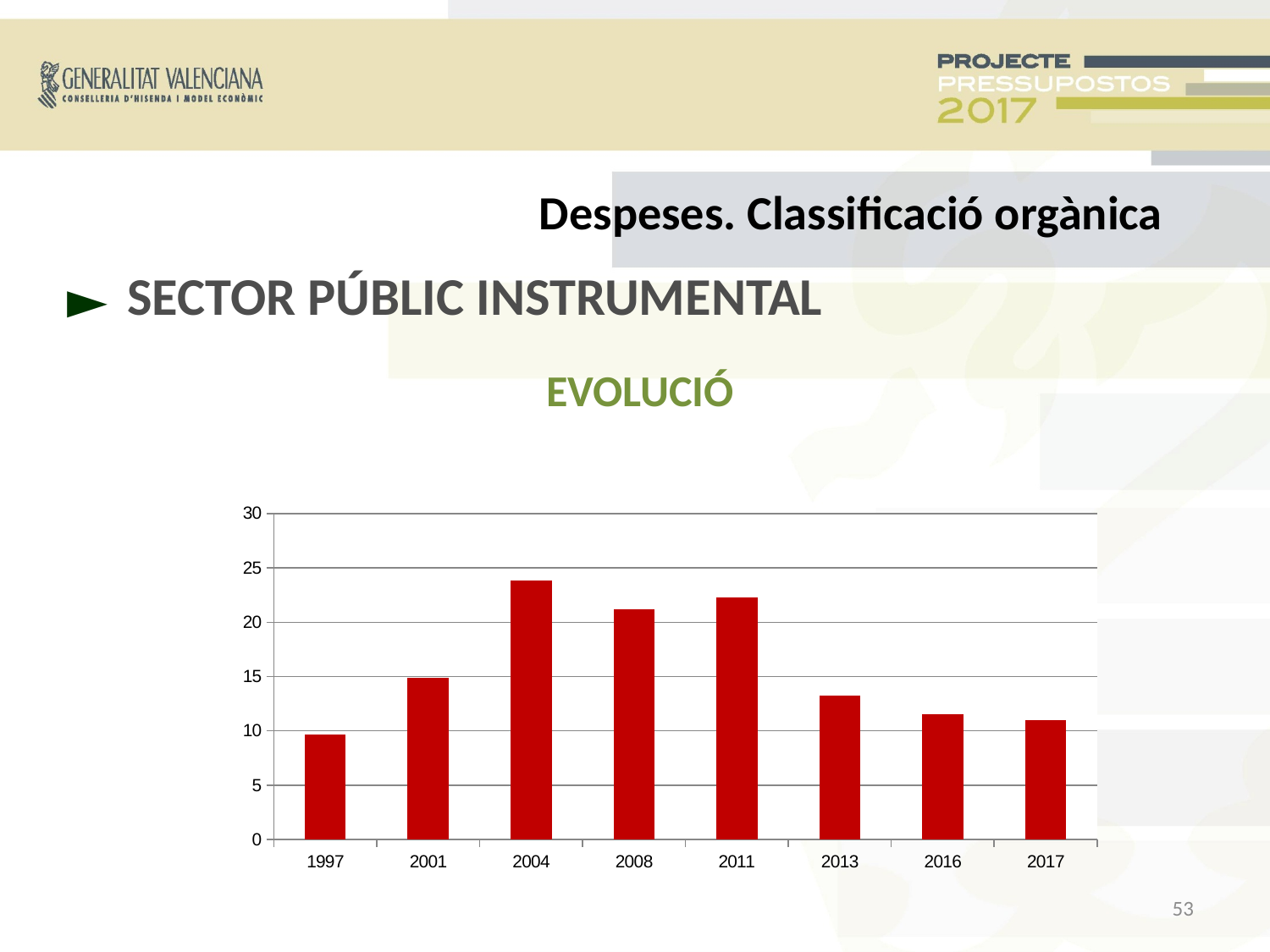
Is the value for 2004 greater or less than 20? greater What kind of chart is shown on the slide? bar chart How many years are shown on the x axis of the chart? 8 Is the value for 2013 greater or less than 15? less Which is larger, the value for 2004 or the value for 2008? 2004 Which is larger, the value for 2001 or the value for 2016? 2001 Which year has the highest bar in the chart? 2004 What heading appears directly above the chart? EVOLUCIÓ Is the value for 2017 greater or less than 10? greater Which year has the lowest bar in the chart? 1997 Do the values rise or fall from 2011 to 2017? fall